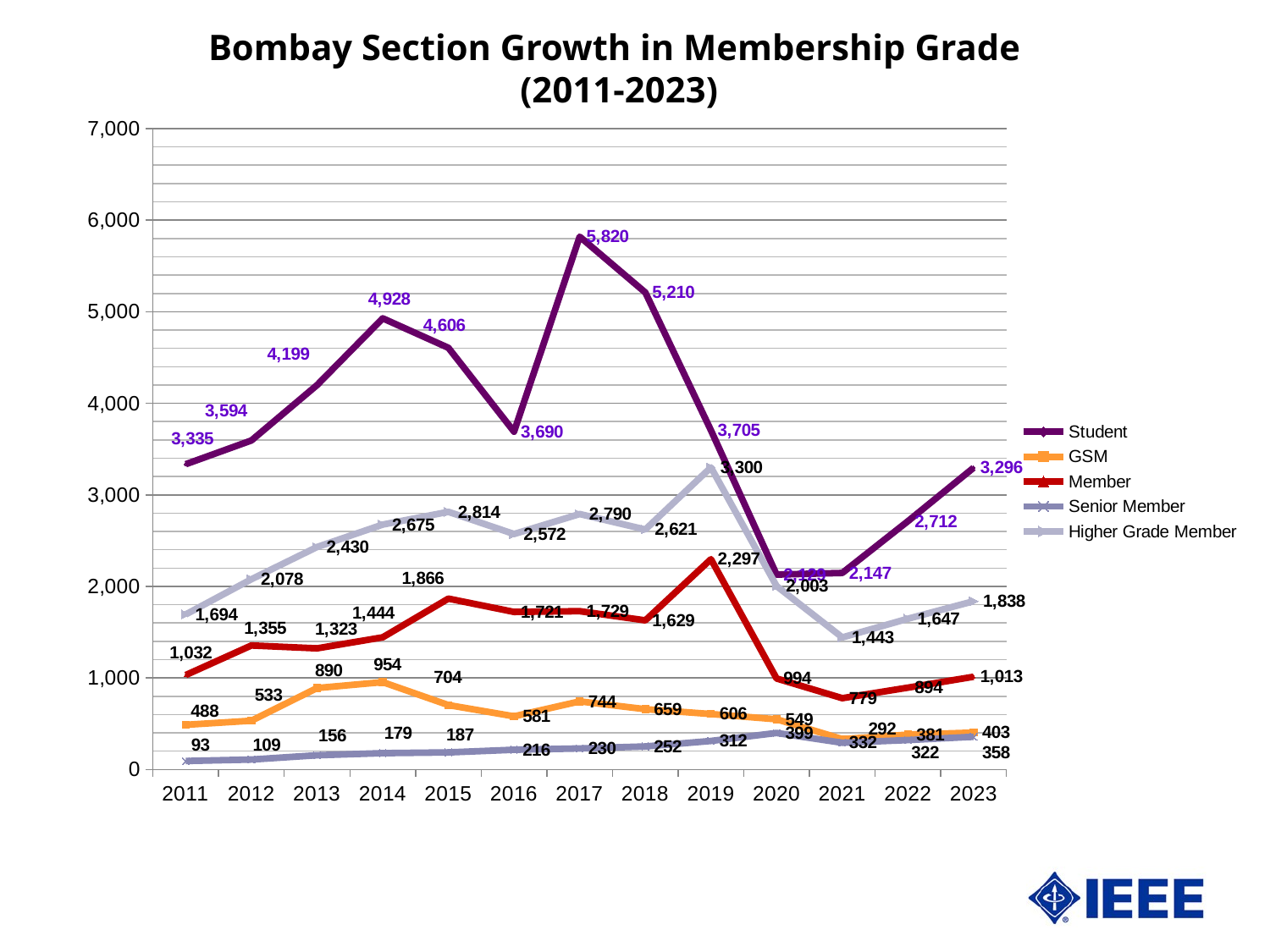
What is the Member value for 2019? 2,297 What is the Higher Grade Member value for 2019? 3,300 What is the difference between the Student values for 2017 and 2018? 610 What type of chart is shown on the slide? line chart How many series does the legend list? 5 Is the Student value for 2014 greater or less than 4,000? greater Does the Senior Member series rise or fall from 2011 to 2019? rise Which is larger in 2014, the GSM value or the Member value? Member How many years are plotted along the x axis? 13 In which year is the Student series at its highest? 2017 What is the Student value for 2017? 5,820 In which year is the Senior Member series at its lowest? 2011